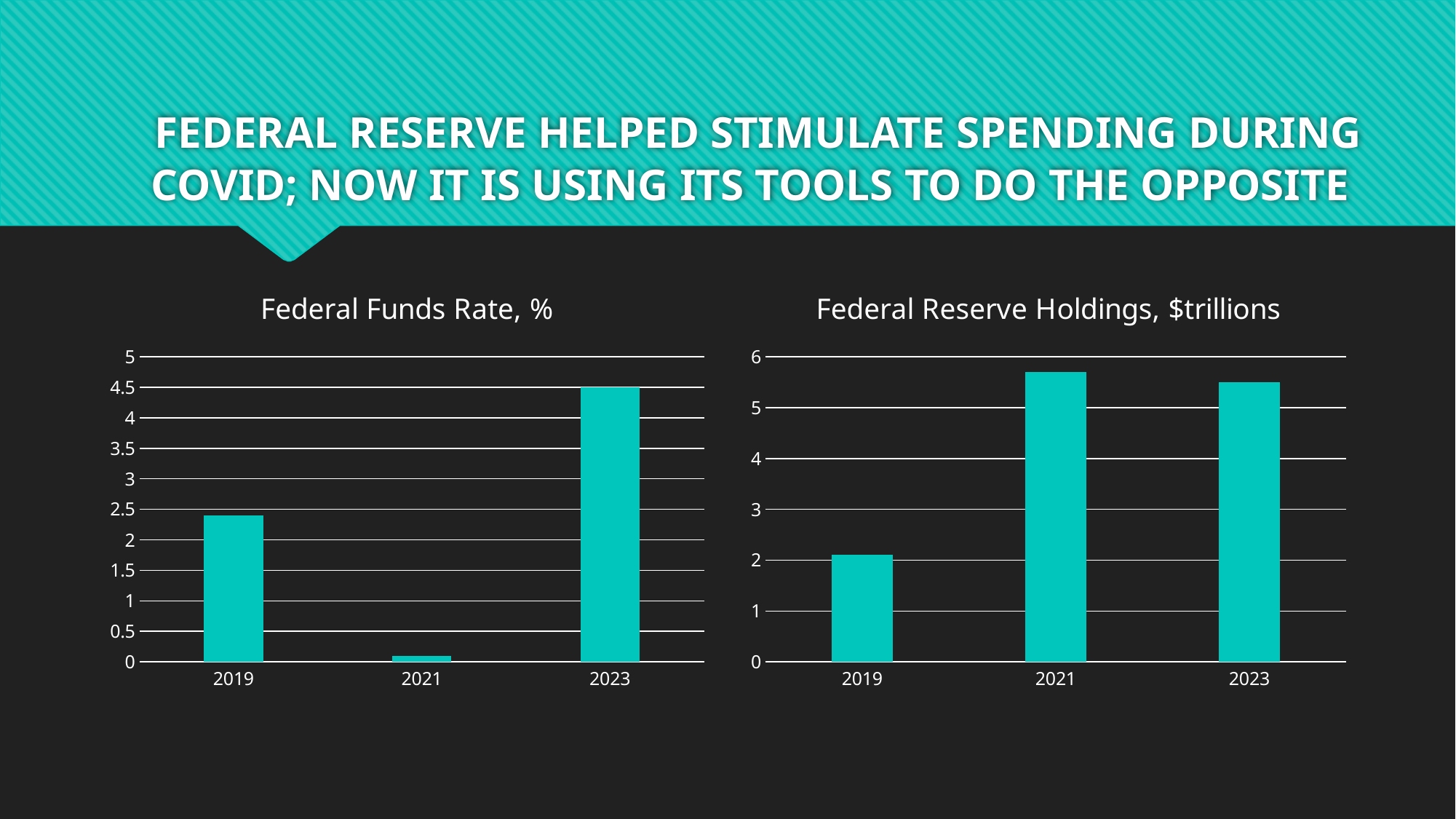
On the Federal Funds Rate, % chart, is the value for 2023 greater or less than 4? greater On the Federal Reserve Holdings, $trillions chart, which is larger, the value for 2019 or the value for 2023? 2023 On the Federal Reserve Holdings, $trillions chart, which year has the lowest value? 2019 What is the title of the chart on the right side of the slide? Federal Reserve Holdings, $trillions On the Federal Reserve Holdings, $trillions chart, is the value for 2021 greater or less than 5? greater On the Federal Funds Rate, % chart, which year has the lowest value? 2021 What kind of chart is the Federal Funds Rate, % chart? bar chart On the Federal Funds Rate, % chart, which year has the highest value? 2023 On the Federal Funds Rate, % chart, is the value for 2019 greater or less than 2? greater How many years are shown on the Federal Funds Rate, % chart? 3